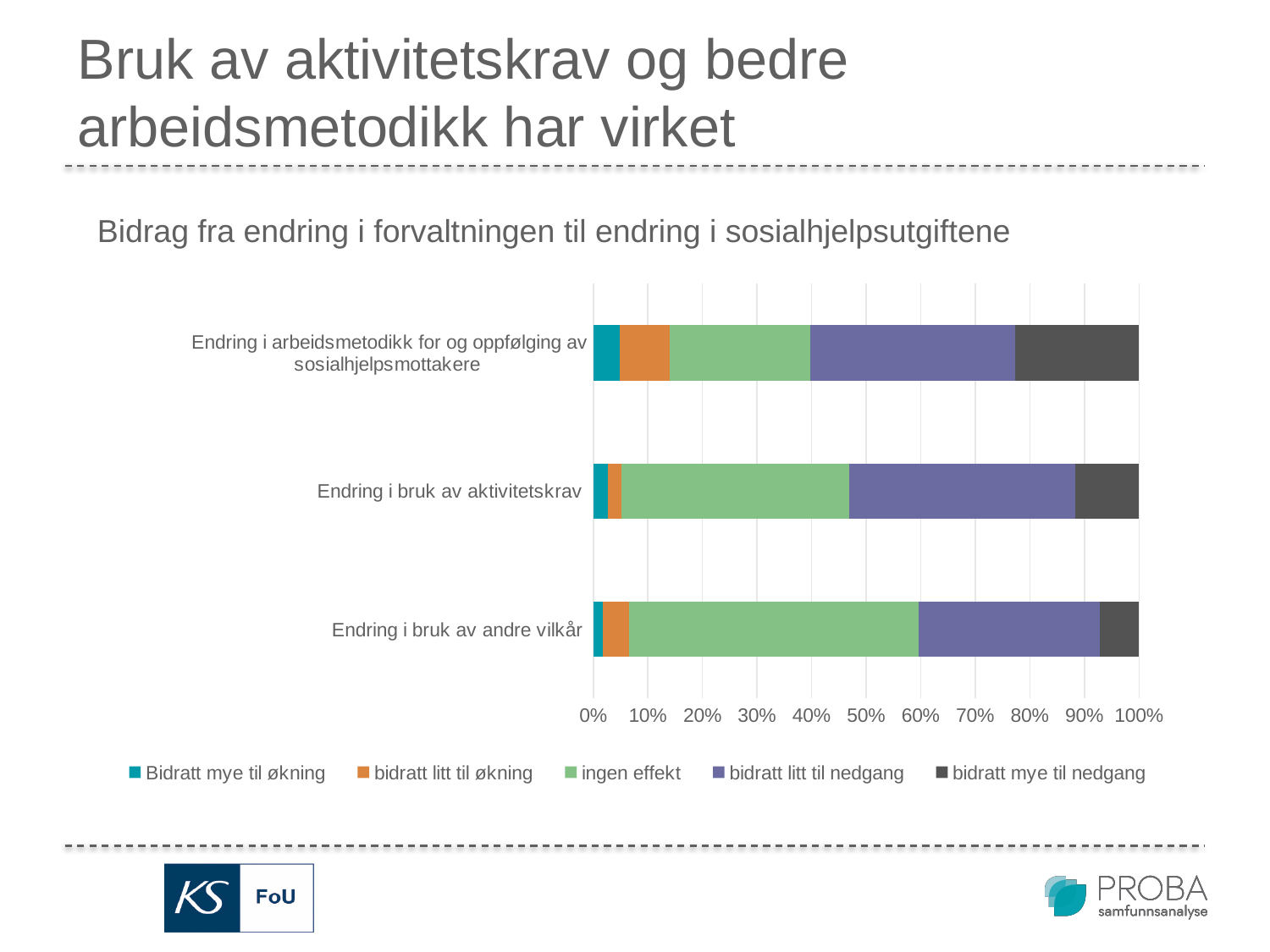
Which has the larger 'bidratt litt til nedgang' segment: 'Endring i bruk av aktivitetskrav' or 'Endring i bruk av andre vilkår'? Endring i bruk av aktivitetskrav Which category has the largest 'bidratt mye til nedgang' segment? Endring i arbeidsmetodikk for og oppfølging av sosialhjelpsmottakere Which legend entry is shown in green? ingen effekt How many categories (bars) does the chart show? 3 Is the 'bidratt mye til nedgang' share for 'Endring i bruk av andre vilkår' greater or less than 10%? less Is the 'ingen effekt' share for 'Endring i arbeidsmetodikk for og oppfølging av sosialhjelpsmottakere' greater or less than 30%? less Is the 'ingen effekt' share for 'Endring i bruk av andre vilkår' greater or less than 50%? greater Which category has the largest 'ingen effekt' segment? Endring i bruk av andre vilkår What kind of chart is shown on the slide? Stacked bar chart How many series does the legend list? 5 Which category has the smallest 'Bidratt mye til økning' segment? Endring i bruk av andre vilkår What is the title of the chart? Bidrag fra endring i forvaltningen til endring i sosialhjelpsutgiftene